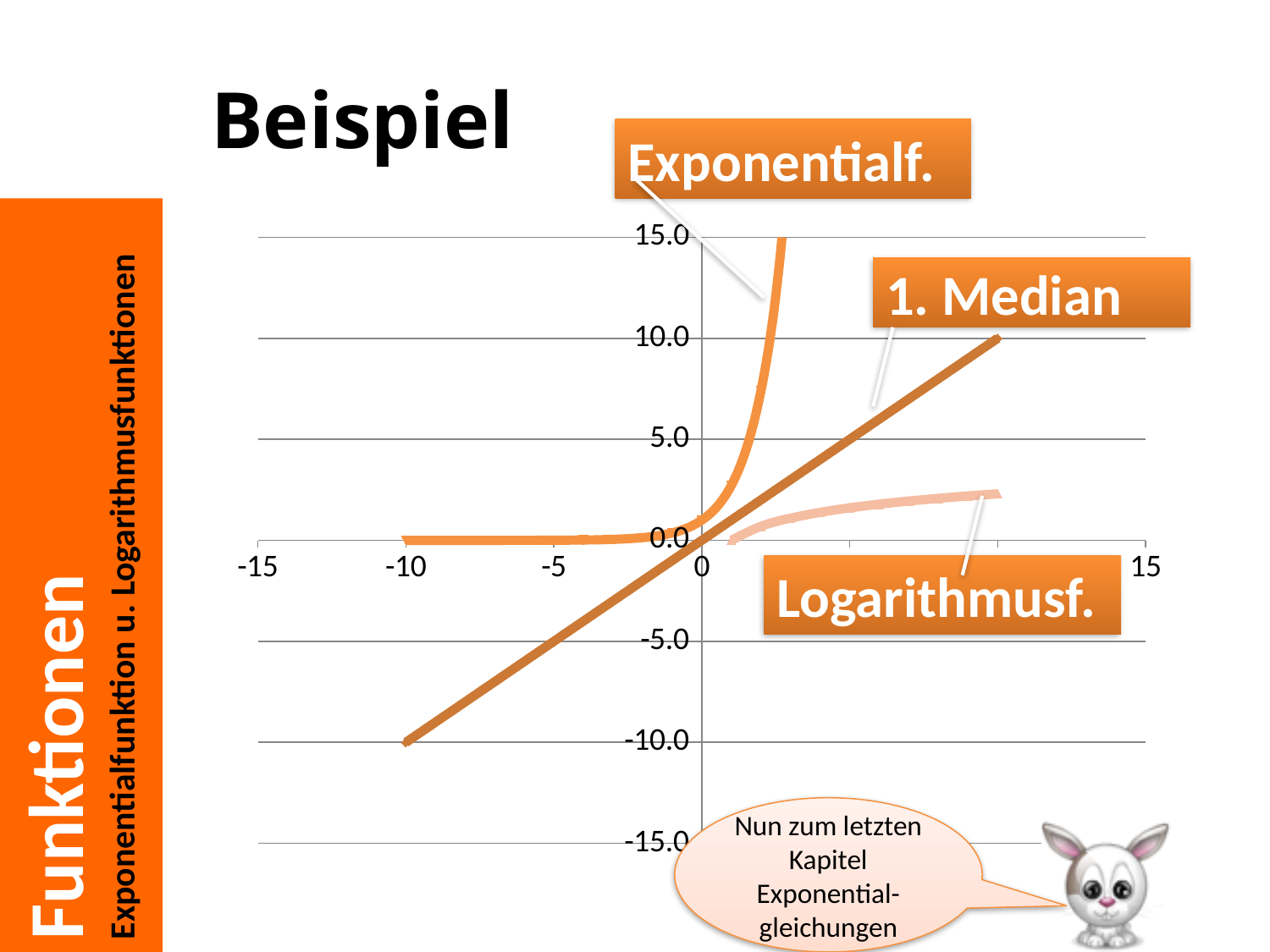
What kind of chart is shown on the slide? line chart Is the value of the "1. Median" curve at x = -5 greater or less than 0? less Is the value of the "1. Median" curve at x = 5 greater or less than 10? less Does the curve labelled "Exponentialf." rise or fall as x increases? rise How many curves are plotted on the chart? 3 What is the highest tick value shown on the vertical axis? 15.0 Is the value of the "Exponentialf." curve at x = -10 greater or less than 5? less At x = 10, which curve is higher: "1. Median" or "Logarithmusf."? 1. Median At x = 2, which curve is higher: "Exponentialf." or "1. Median"? Exponentialf. Does the curve labelled "1. Median" rise or fall as x increases? rise Which of the three labelled curves is a straight line? 1. Median